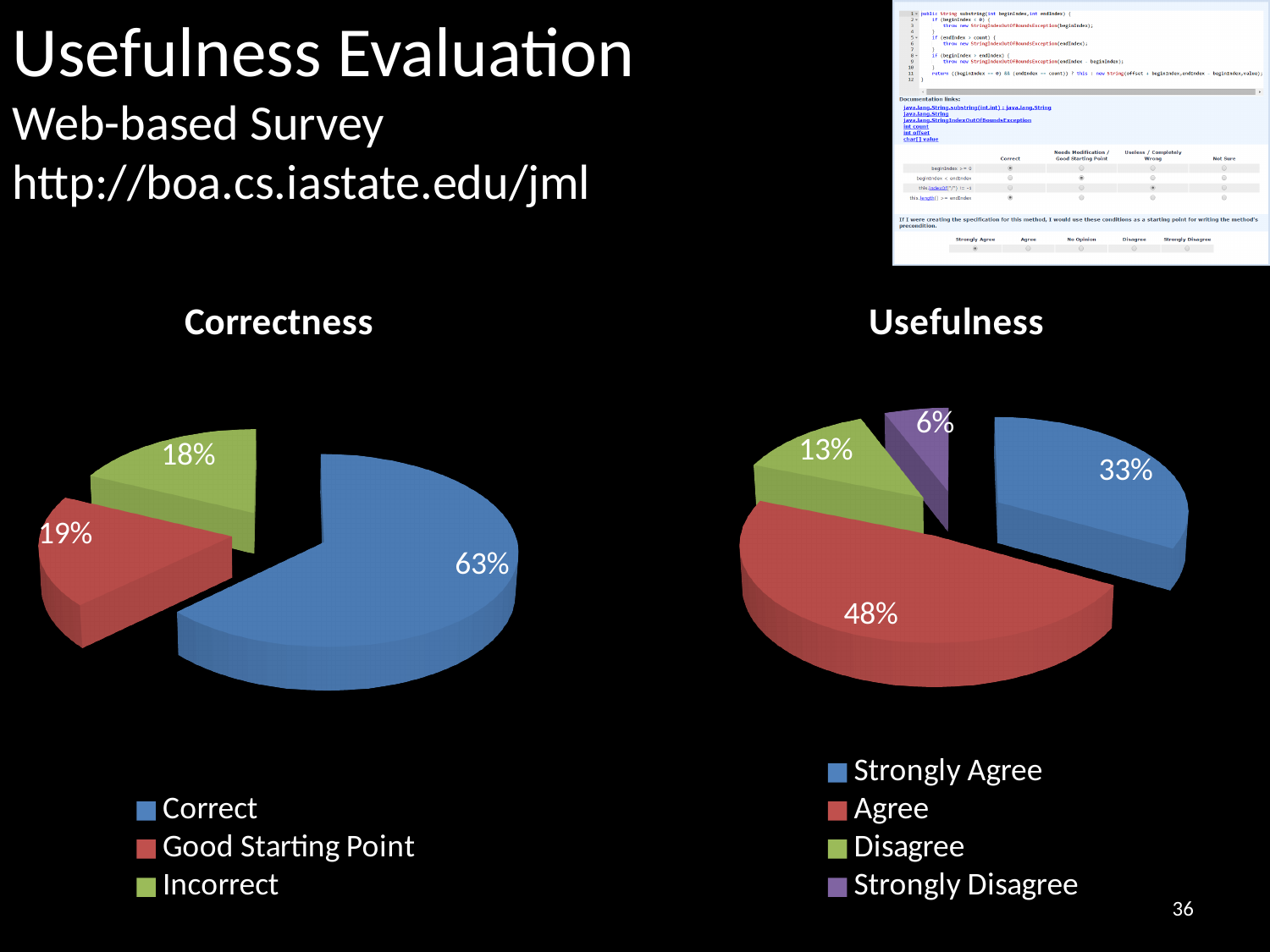
In the Usefulness pie chart, what is the difference between the Agree and Strongly Agree shares? 15% In the Usefulness pie chart, which response category has the smallest share? Strongly Disagree In the Correctness pie chart, which category has the smallest share? Incorrect In the Correctness pie chart, what percentage is labelled Good Starting Point? 19% In the Correctness pie chart, what share of responses were Correct? 63% How many categories does the Usefulness pie chart's legend list? 4 In the Usefulness pie chart, what share of respondents chose Agree? 48% In the Usefulness pie chart, which response category has the largest share? Agree In the Correctness pie chart, what percentage of responses were Incorrect? 18% In the Correctness pie chart, which is larger: Correct or Good Starting Point? Correct In the Usefulness pie chart, what percentage chose Strongly Disagree? 6% What type of chart is used for Correctness? Pie chart